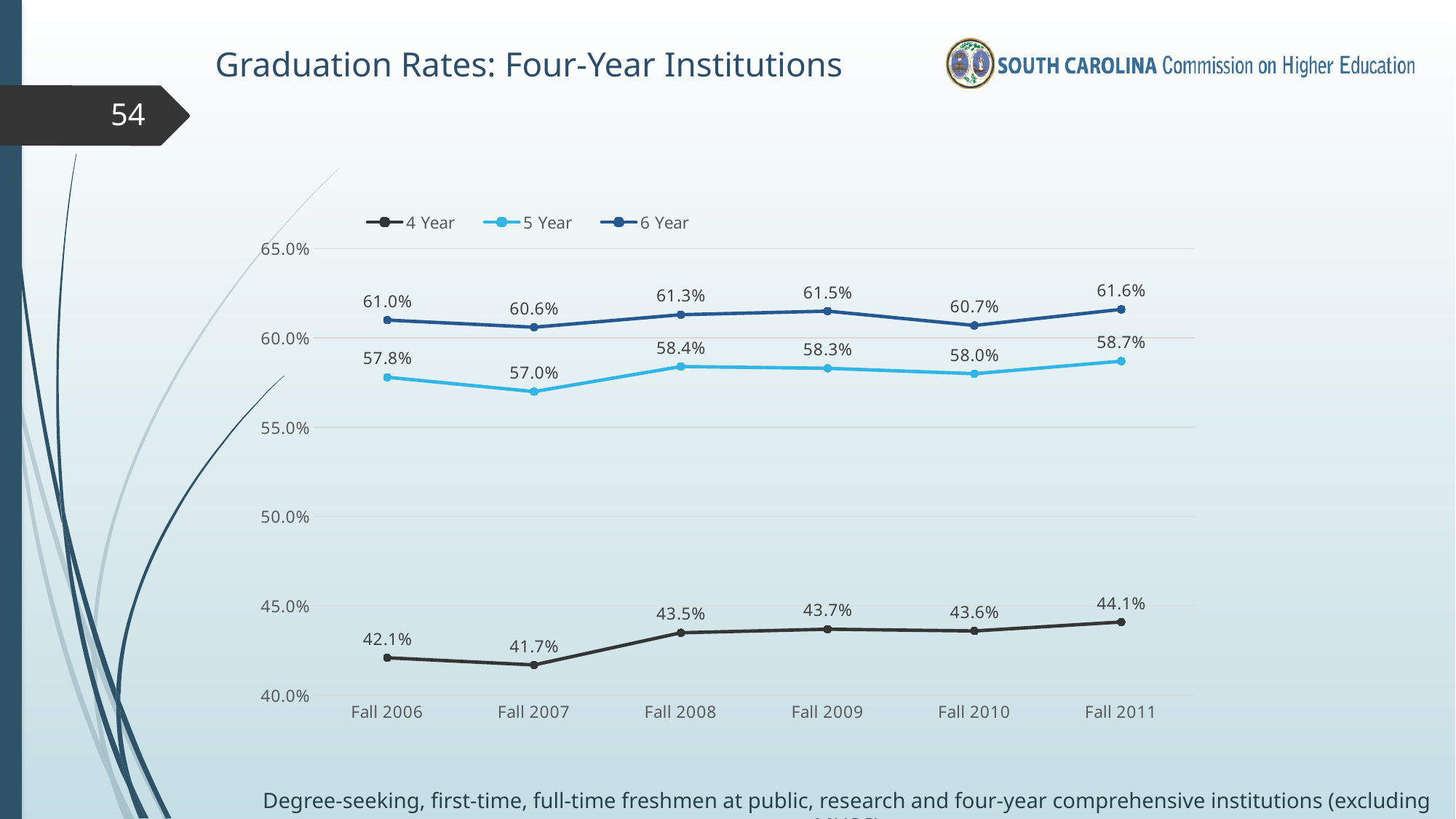
Which cohort has the lowest 5 Year graduation rate? Fall 2007 Does the 4 Year graduation rate rise or fall from Fall 2007 to Fall 2008? rise How many cohorts are shown on the x axis? 6 What is the 4 Year graduation rate for Fall 2011? 44.1% What is the 6 Year graduation rate for Fall 2009? 61.5% Is the 6 Year graduation rate higher for Fall 2008 or Fall 2010? Fall 2008 What is the 5 Year graduation rate for Fall 2007? 57.0% What is the difference between the 6 Year and 4 Year graduation rates for Fall 2006? 18.9% How many series does the legend list? 3 What kind of chart is shown on the slide? line chart Which cohort has the highest 4 Year graduation rate? Fall 2011 Is the 5 Year graduation rate for Fall 2011 greater or less than 60.0%? less